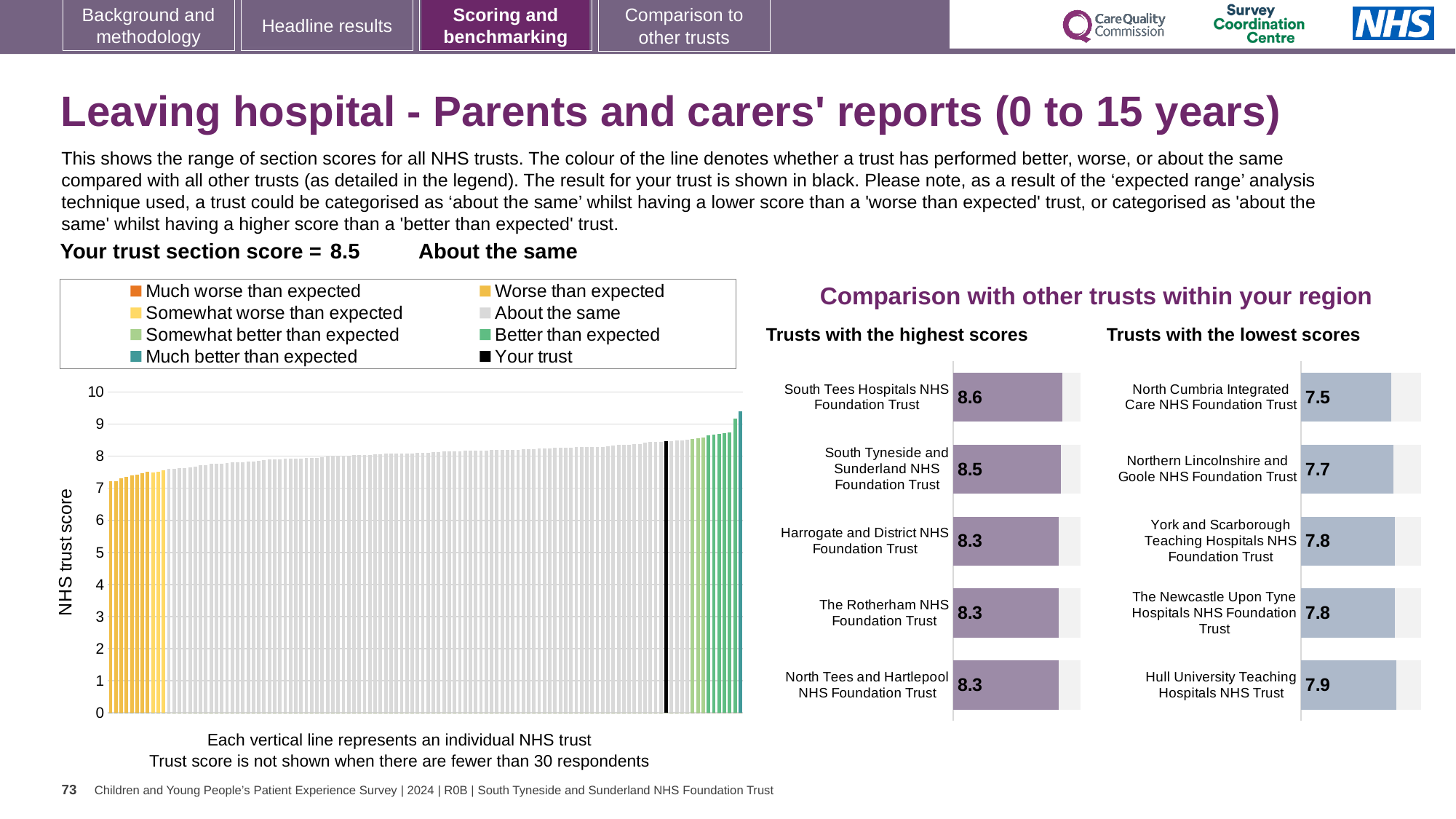
In the 'Trusts with the lowest scores' chart, which trust has the lowest score? North Cumbria Integrated Care NHS Foundation Trust How many trusts are shown in the 'Trusts with the lowest scores' chart? 5 In the 'Trusts with the highest scores' chart, what is the difference between the scores of South Tees Hospitals NHS Foundation Trust and South Tyneside and Sunderland NHS Foundation Trust? 0.1 In the 'Trusts with the lowest scores' chart, what is the difference between the scores of Hull University Teaching Hospitals NHS Trust and North Cumbria Integrated Care NHS Foundation Trust? 0.4 In the 'Trusts with the highest scores' chart, which trust has the highest score? South Tees Hospitals NHS Foundation Trust In the 'Trusts with the highest scores' chart, what is the score for Harrogate and District NHS Foundation Trust? 8.3 In the large chart on the left showing all NHS trusts, is the value for the black 'Your trust' bar greater or less than 8? greater In the 'Trusts with the lowest scores' chart, what is the score for North Cumbria Integrated Care NHS Foundation Trust? 7.5 In the 'Trusts with the highest scores' chart, what is the score for South Tees Hospitals NHS Foundation Trust? 8.6 Which has a higher score: Northern Lincolnshire and Goole NHS Foundation Trust in the 'lowest scores' chart or The Rotherham NHS Foundation Trust in the 'highest scores' chart? The Rotherham NHS Foundation Trust How many entries does the legend of the large chart on the left list? 8 In the 'Trusts with the lowest scores' chart, what is the score for Hull University Teaching Hospitals NHS Trust? 7.9